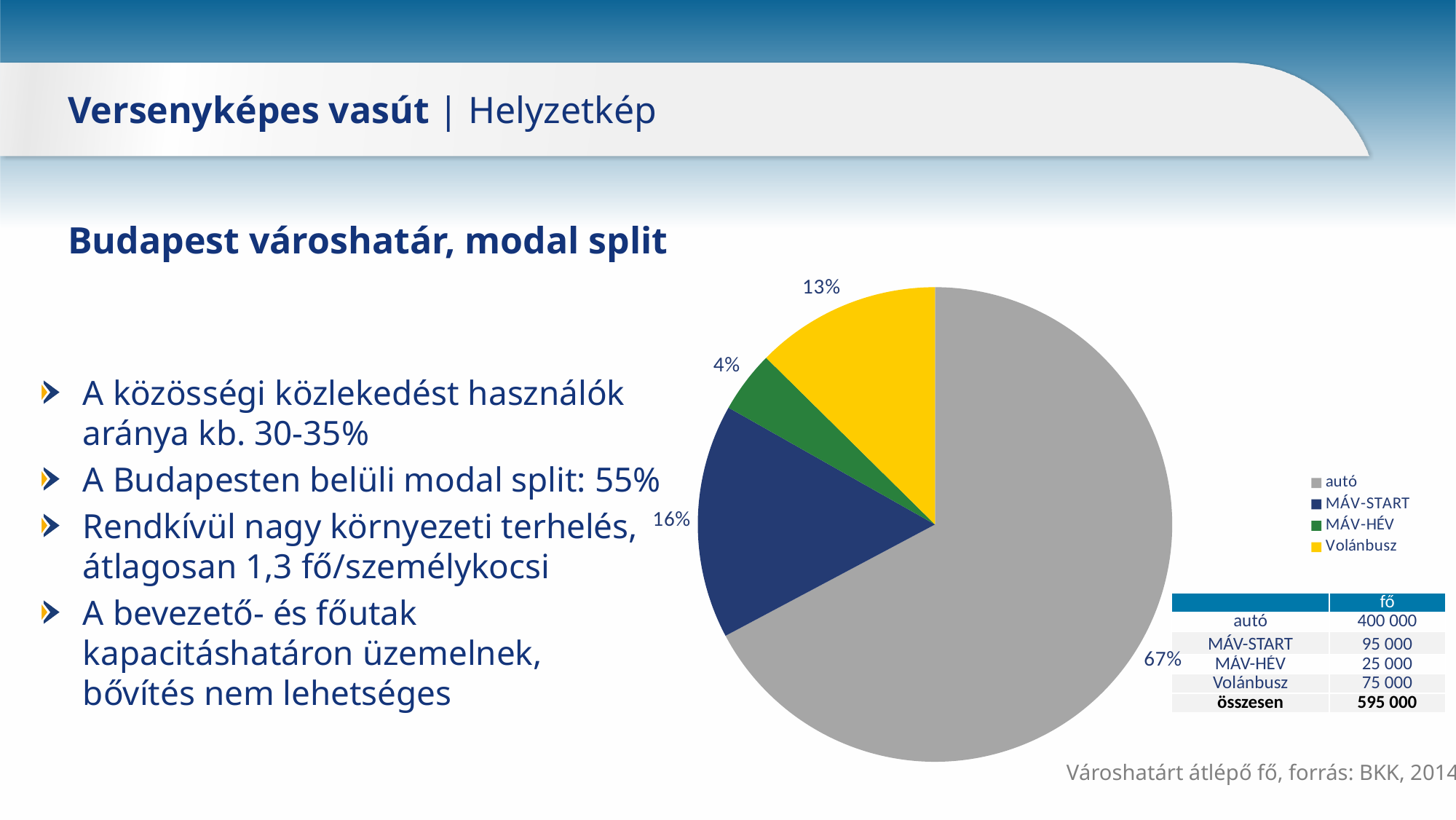
What share of the pie does Volánbusz have? 13% What share of the pie does MÁV-START have? 16% What is the difference in percentage points between the autó slice and the MÁV-START slice? 51 What kind of chart is shown on the slide? pie chart What share of the pie does MÁV-HÉV have? 4% How many slices does the pie chart have? 4 How many entries does the legend list? 4 What colour is the Volánbusz slice in the pie chart? yellow Which category has the smallest slice of the pie? MÁV-HÉV Which category has the largest slice of the pie? autó Which slice is larger, MÁV-START or Volánbusz? MÁV-START